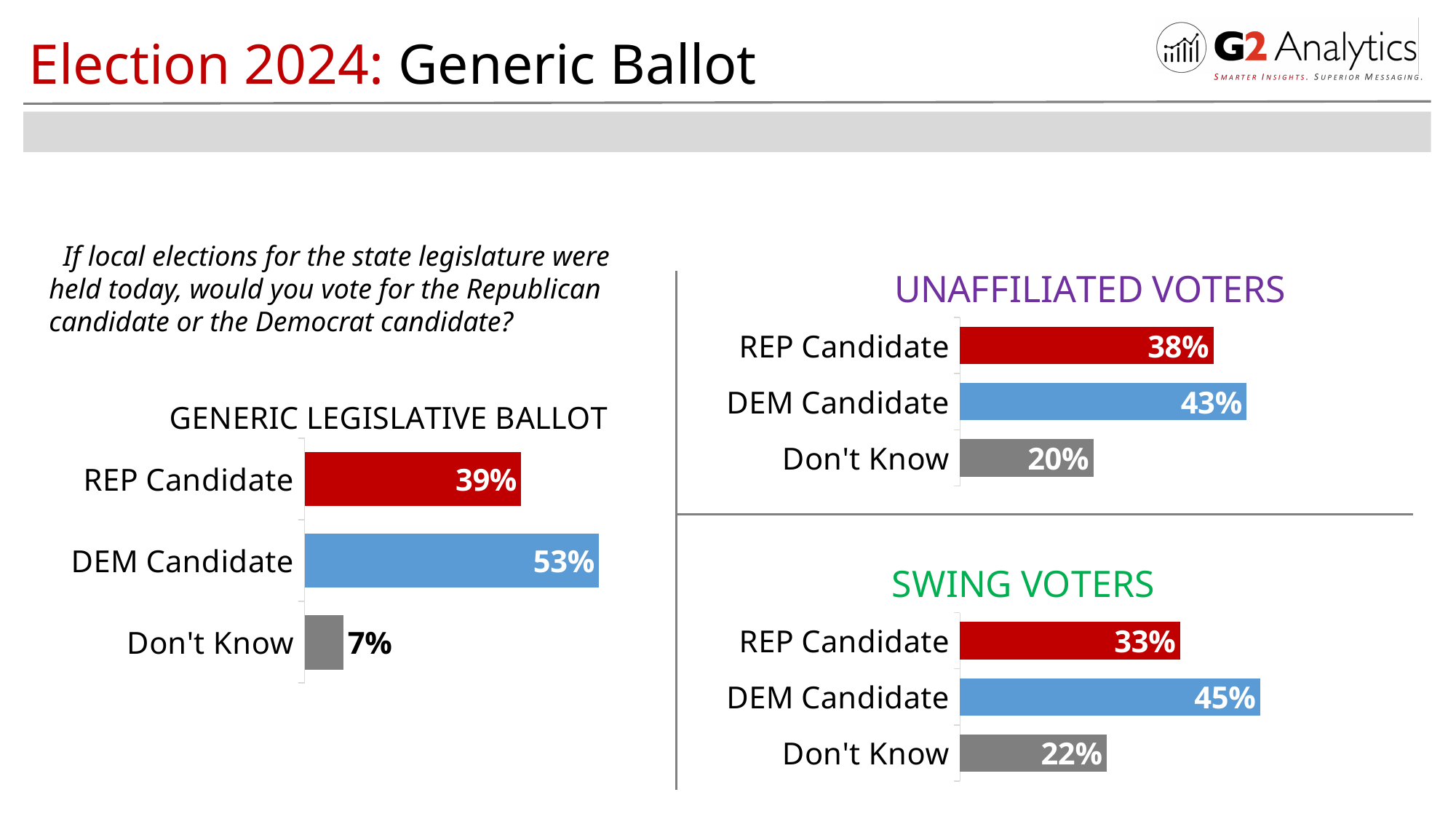
In the Generic Legislative Ballot chart, which category has the highest value? DEM Candidate How many categories does the Swing Voters chart show? 3 What colour is the DEM Candidate bar in the Swing Voters chart? Blue In the Swing Voters chart, what is the value for Don't Know? 22% In the Unaffiliated Voters chart, which category has the lowest value? Don't Know In the Unaffiliated Voters chart, which is larger, REP Candidate or DEM Candidate? DEM Candidate What kind of chart is the Generic Legislative Ballot chart? Bar chart In the Generic Legislative Ballot chart, what is the difference between DEM Candidate and REP Candidate? 14% In the Swing Voters chart, what is the difference between DEM Candidate and REP Candidate? 12% In the Unaffiliated Voters chart, what is the value for REP Candidate? 38% In the Generic Legislative Ballot chart, what is the value for Don't Know? 7% In the Generic Legislative Ballot chart, what is the value for DEM Candidate? 53%